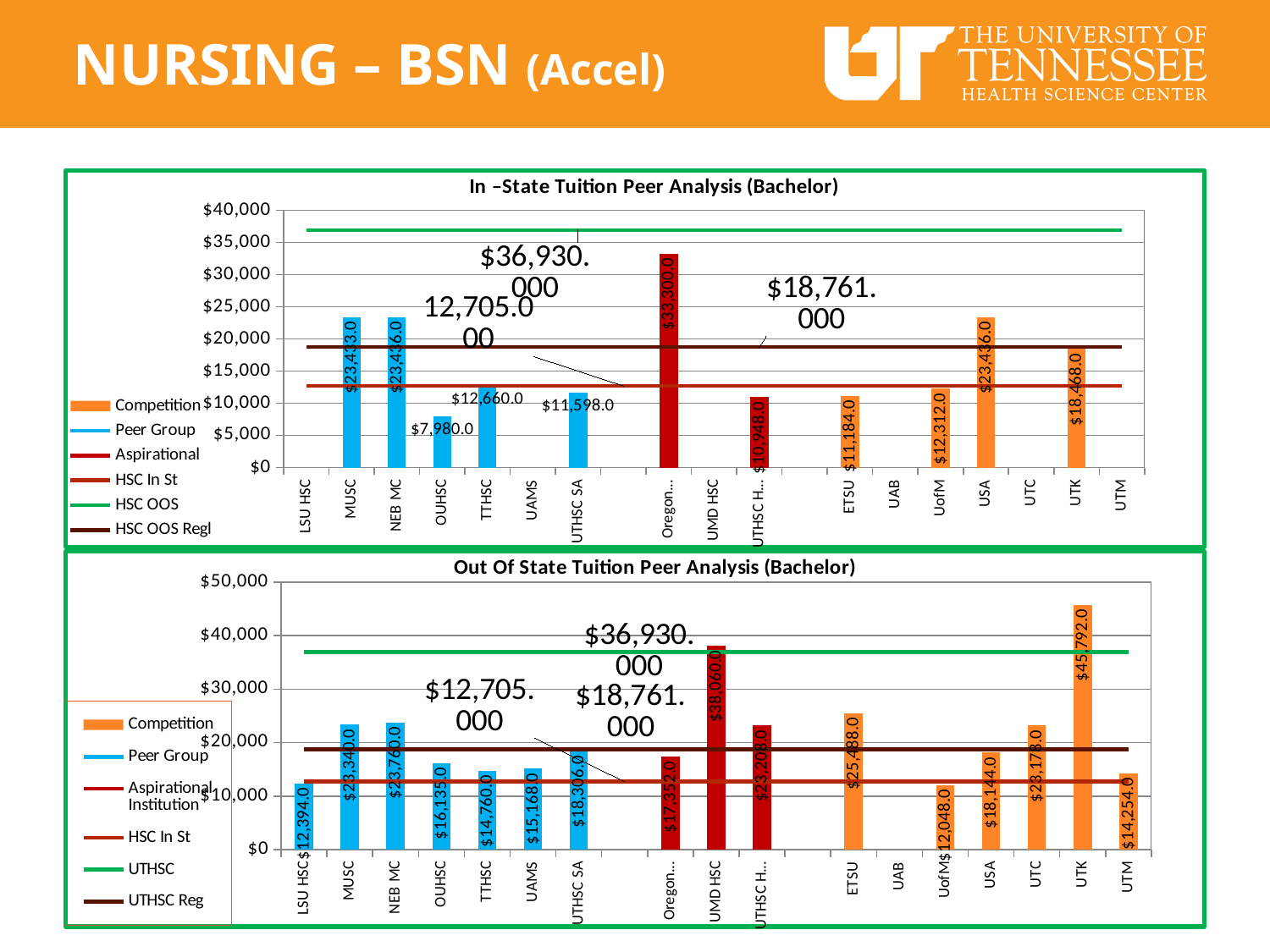
In the In-State Tuition Peer Analysis chart, which is larger, the value for TTHSC or the value for UTHSC SA? TTHSC In the Out Of State Tuition Peer Analysis chart, is the value for ETSU greater or less than $20,000? greater In the Out Of State Tuition Peer Analysis chart, what is the value for UMD HSC? $38,060.0 In the In-State Tuition Peer Analysis chart, what is the difference between the values for NEB MC and MUSC? $3.0 In the In-State Tuition Peer Analysis chart, what is the value for UTK? $18,468.0 In the Out Of State Tuition Peer Analysis chart, which institution has the highest bar? UTK In the In-State Tuition Peer Analysis chart, what is the value for OUHSC? $7,980.0 What kind of chart is the Out Of State Tuition Peer Analysis chart? bar chart How many entries does the legend of the In-State Tuition Peer Analysis chart list? 6 In the Out Of State Tuition Peer Analysis chart, what is the value for UTHSC SA? $18,306.0 In the Out Of State Tuition Peer Analysis chart, what is the difference between the values for UTK and UMD HSC? $7,732.0 In the In-State Tuition Peer Analysis chart, which institution has the lowest bar? OUHSC